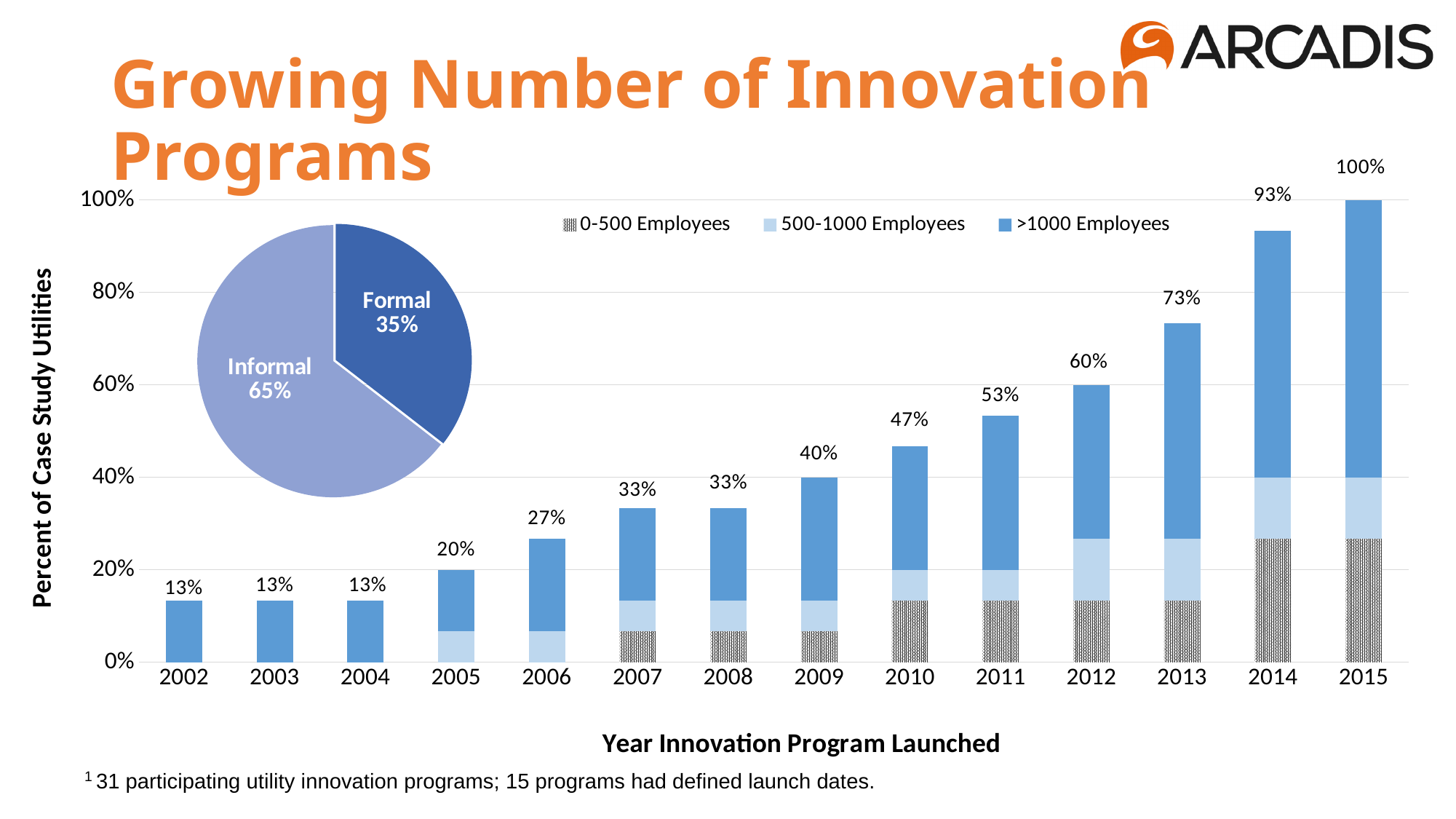
In the bar chart, what is the total percentage of case study utilities for 2012? 60% In the bar chart, which year has the highest total percentage? 2015 How many years are shown on the x axis of the bar chart? 14 In the bar chart, what is the lowest total percentage shown on any bar? 13% How many series does the legend of the bar chart list? 3 In the bar chart, is the 0-500 Employees segment for 2014 greater or less than 20%? greater In the pie chart, what share is labelled Formal? 35% In the bar chart, what is the difference between the total for 2015 and the total for 2014? 7 percentage points In the bar chart, what is the total value shown for 2009? 40% In the bar chart, do the total values rise or fall from 2002 to 2015? Rise In the bar chart, which year has a larger total: 2010 or 2011? 2011 What kind of chart is the large chart showing years 2002 to 2015? Stacked bar chart